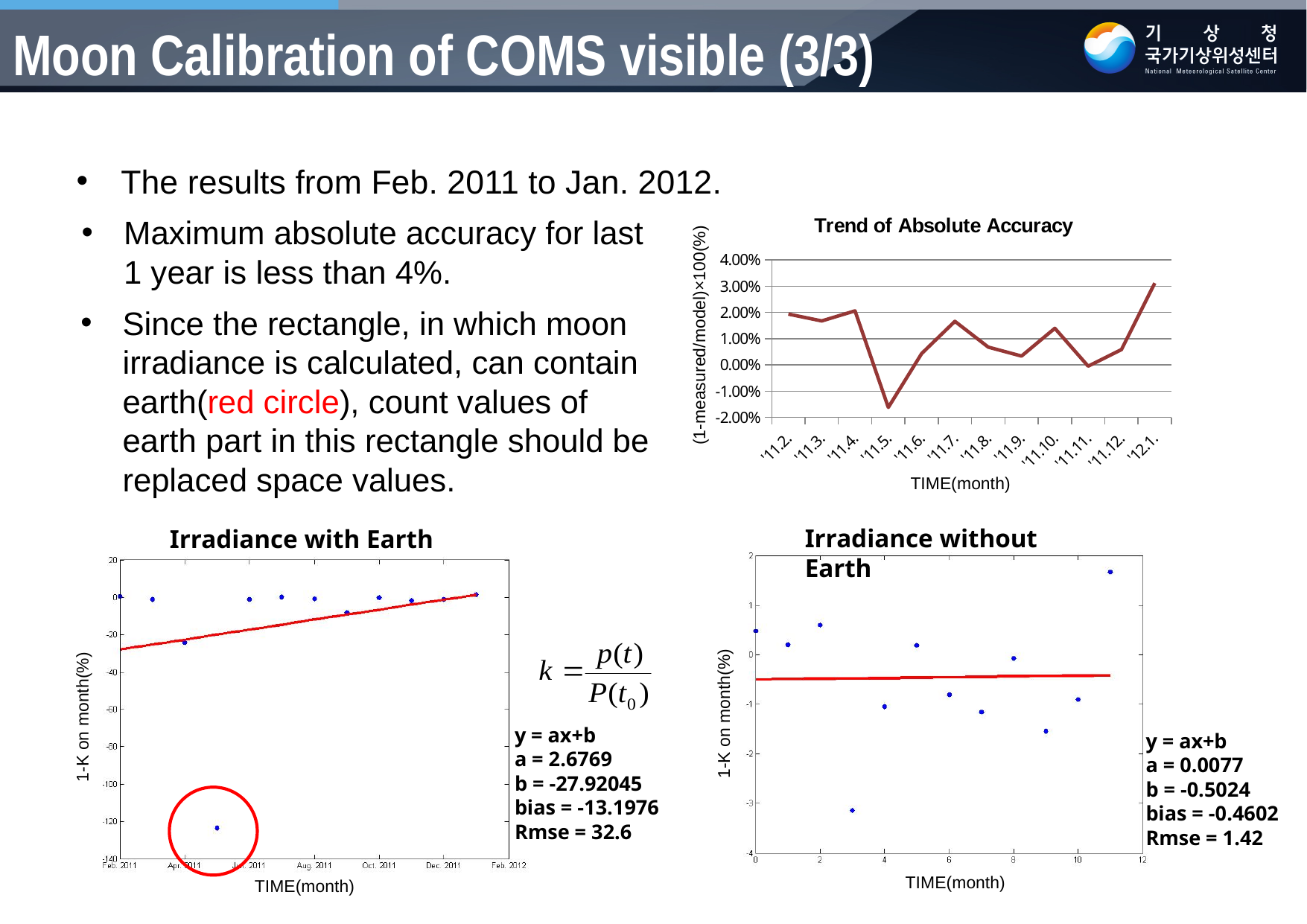
In the 'Trend of Absolute Accuracy' chart, which month has the lowest value? '11.5. In the 'Trend of Absolute Accuracy' chart, is the value for '11.5. greater or less than -1.00%? less What is the x-axis label of the 'Trend of Absolute Accuracy' chart? TIME(month) In the 'Trend of Absolute Accuracy' chart, which is larger, the value for '11.4. or the value for '11.9.? '11.4. What is the Rmse value printed next to the 'Irradiance without Earth' chart? 1.42 What is the value of a printed next to the 'Irradiance with Earth' chart? 2.6769 In the 'Trend of Absolute Accuracy' chart, how many months are plotted along the x axis? 12 In the 'Trend of Absolute Accuracy' chart, which month has the highest value? '12.1. What type of chart is the 'Trend of Absolute Accuracy' chart? line chart In the 'Trend of Absolute Accuracy' chart, is the value for '11.2. greater or less than 1.00%? greater In the 'Irradiance with Earth' chart, is the value of the point inside the red circle greater or less than -100? less